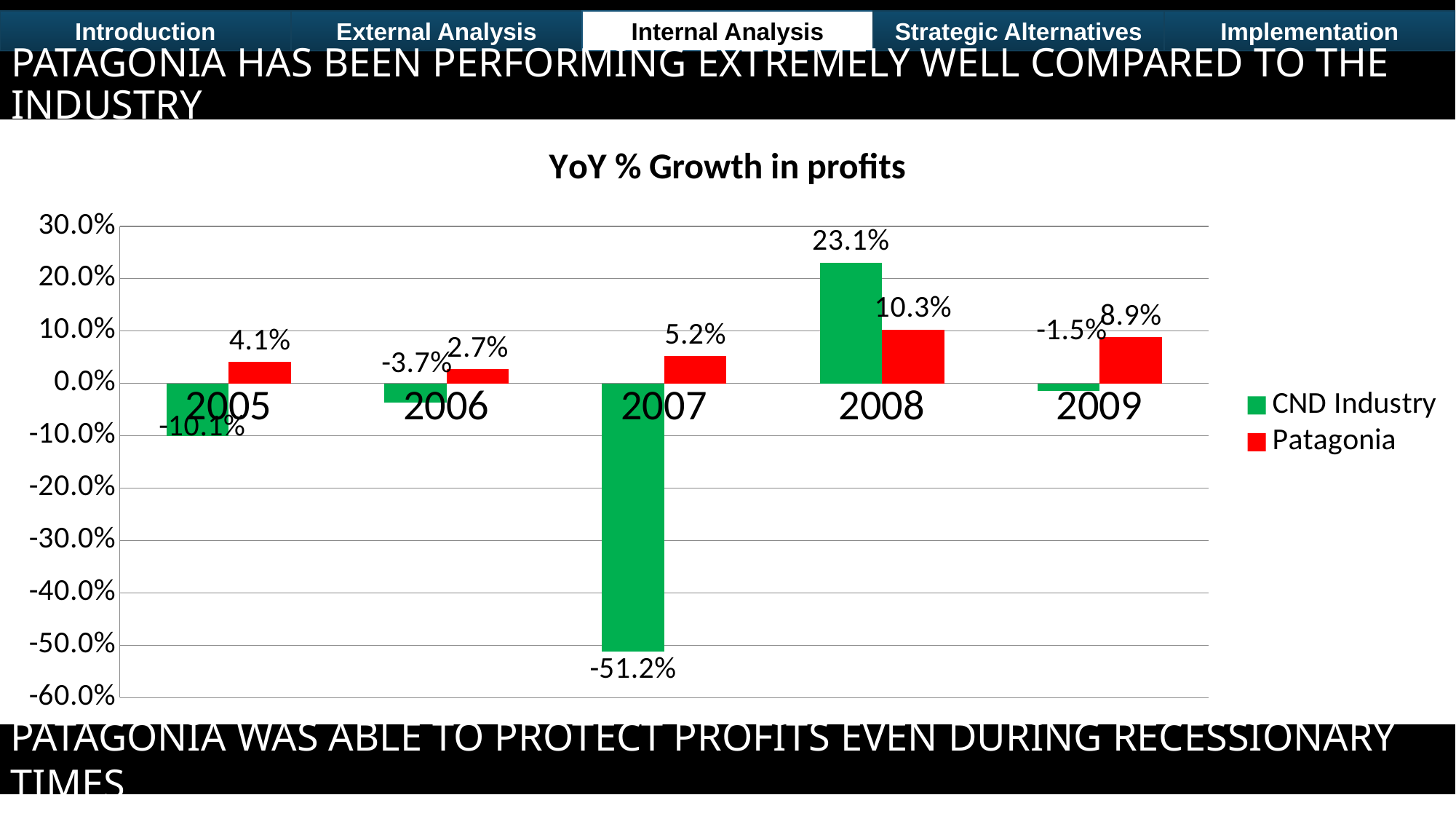
What is the title of the chart? YoY % Growth in profits Which colour represents Patagonia in the chart? red How many series does the legend list? 2 In which year is the CND Industry value lowest? 2007 What is the Patagonia value for 2008? 10.3% What is the CND Industry value for 2009? -1.5% What is the difference between the CND Industry and Patagonia values in 2008? 12.8% Which is larger in 2005, the CND Industry value or the Patagonia value? Patagonia What type of chart is shown on the slide? bar chart What is the CND Industry value for 2007? -51.2% How many years are shown on the x axis? 5 In which year is the Patagonia value highest? 2008